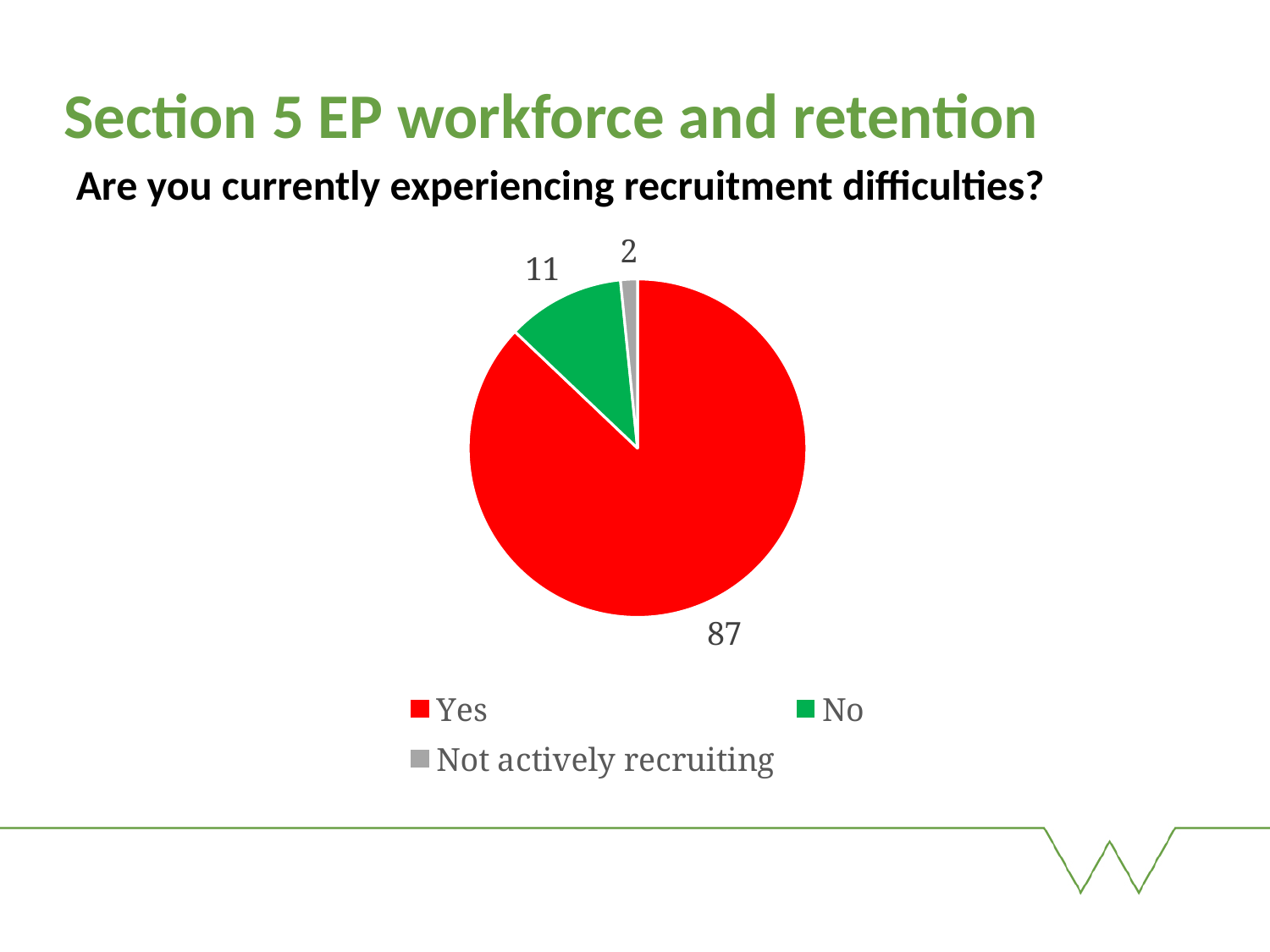
Which is larger, the value for "No" or the value for "Not actively recruiting"? No How many categories does the pie chart show? 3 Which category has the smallest slice of the pie chart? Not actively recruiting Which category has the largest slice of the pie chart? Yes What type of chart is shown on the slide? Pie chart What value is shown for the "Not actively recruiting" slice of the pie chart? 2 What is the difference between the values for "No" and "Not actively recruiting"? 9 What share of the pie does the "Yes" slice represent? 87% What is the difference between the values for "Yes" and "No"? 76 What value is shown for the "No" slice of the pie chart? 11 What colour is the "Yes" slice in the pie chart? Red What value is shown for the "Yes" slice of the pie chart? 87